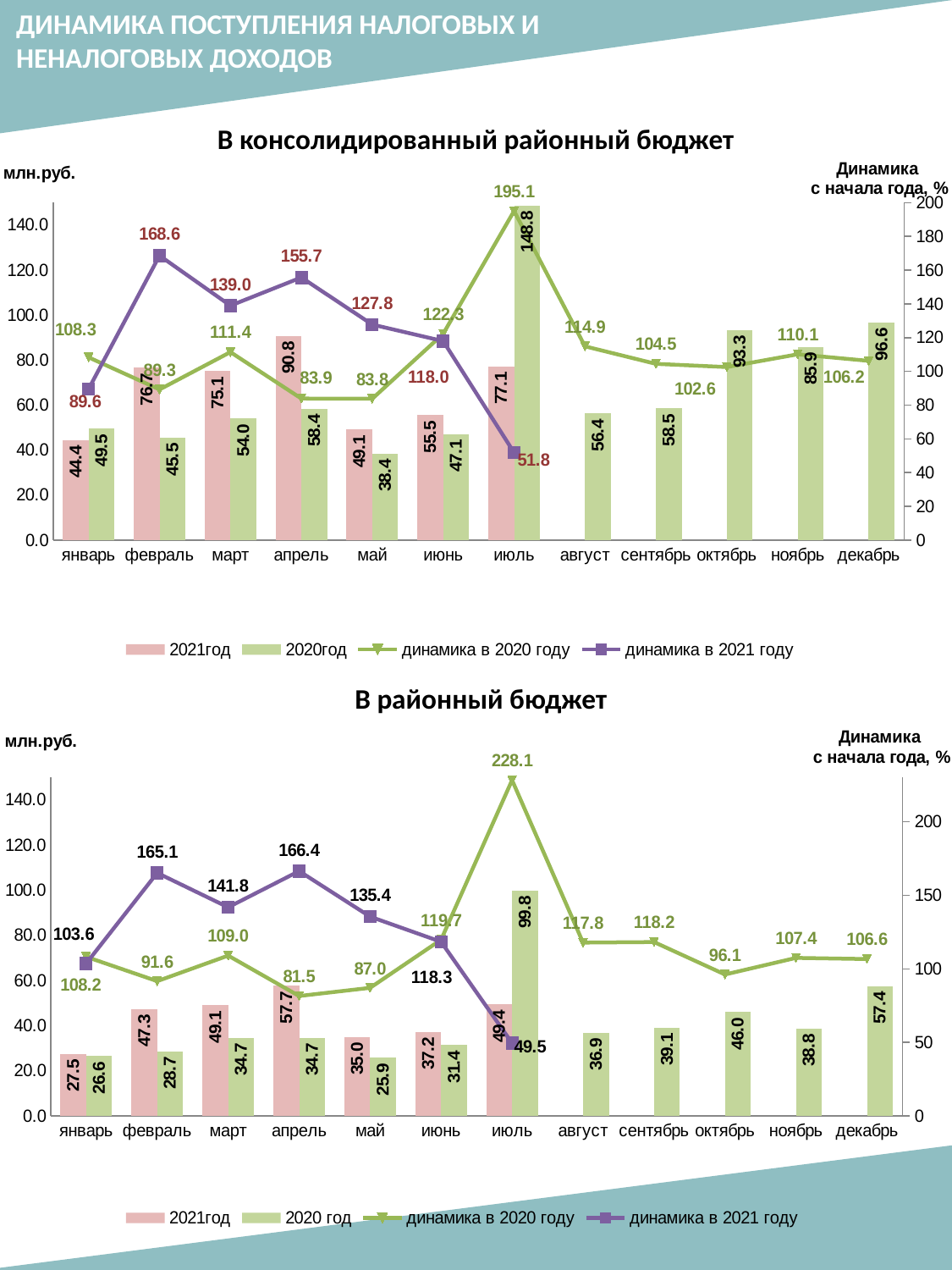
How many months are shown on the x axis of the chart 'В районный бюджет'? 12 How many series does the legend of the chart 'В консолидированный районный бюджет' list? 4 In the chart 'В районный бюджет', which month has the lowest 2020 год bar? май In the chart 'В консолидированный районный бюджет', what is the value of the 2020год bar for июль? 148.8 In the chart 'В консолидированный районный бюджет', which month has the highest 2020год bar? июль In the chart 'В районный бюджет', what is the value of the 2021год bar for апрель? 57.7 In the chart 'В консолидированный районный бюджет', what is the value of 'динамика в 2021 году' for июль? 51.8 In the chart 'В консолидированный районный бюджет', which is larger for март: the 2021год bar or the 2020год bar? 2021год In the chart 'В консолидированный районный бюджет', what is the value of the 2021год bar for апрель? 90.8 In the chart 'В консолидированный районный бюджет', what is the difference between the 2021год and 2020год values for февраль? 31.2 In the chart 'В районный бюджет', what is the difference between the 2020 год and 2021год values for июль? 50.4 In the chart 'В районный бюджет', what is the value of 'динамика в 2020 году' for июль? 228.1